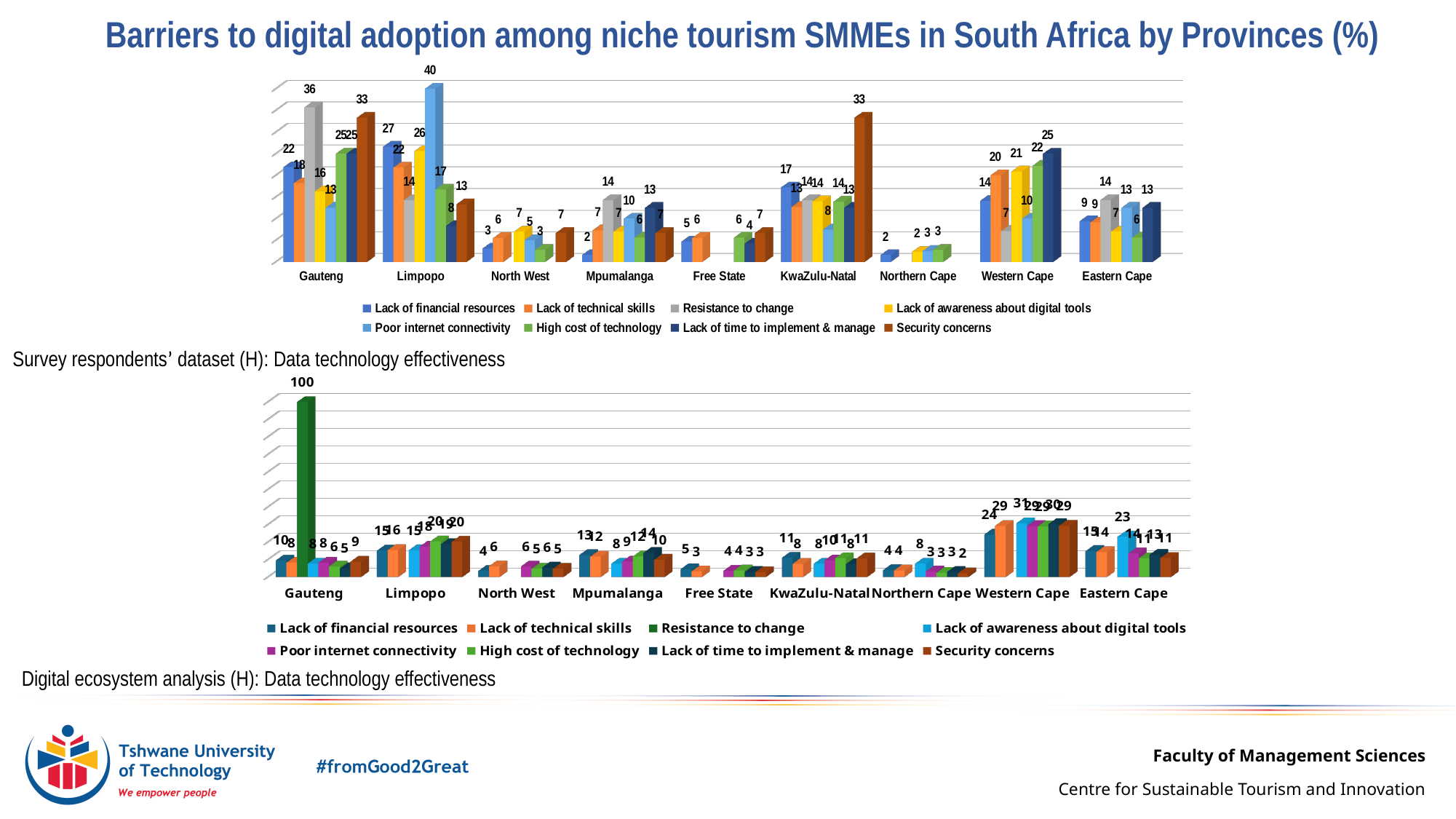
In the bottom chart (Digital ecosystem analysis), which province has the single highest bar? Gauteng In the bottom chart (Digital ecosystem analysis), what is the difference between Lack of financial resources in Western Cape (24) and in Gauteng (10)? 14 In the top chart (Survey respondents' dataset), what is the difference between Poor internet connectivity in Limpopo (40) and Resistance to change in Gauteng (36)? 4 In the bottom chart (Digital ecosystem analysis), what is the value for Resistance to change in Gauteng? 100 In the top chart (Survey respondents' dataset), what is the value for Security concerns in KwaZulu-Natal? 33 How many series does the legend of the bottom chart list? 8 What kind of chart is the top chart on the slide? Bar chart In the top chart (Survey respondents' dataset), which is larger: Poor internet connectivity in Limpopo or Resistance to change in Gauteng? Poor internet connectivity in Limpopo What is the caption shown below the bottom chart? Digital ecosystem analysis (H): Data technology effectiveness How many provinces are shown on the x axis of the top chart? 9 In the top chart (Survey respondents' dataset), what is the value for Resistance to change in Gauteng? 36 In the top chart (Survey respondents' dataset), what is the value for Poor internet connectivity in Limpopo? 40